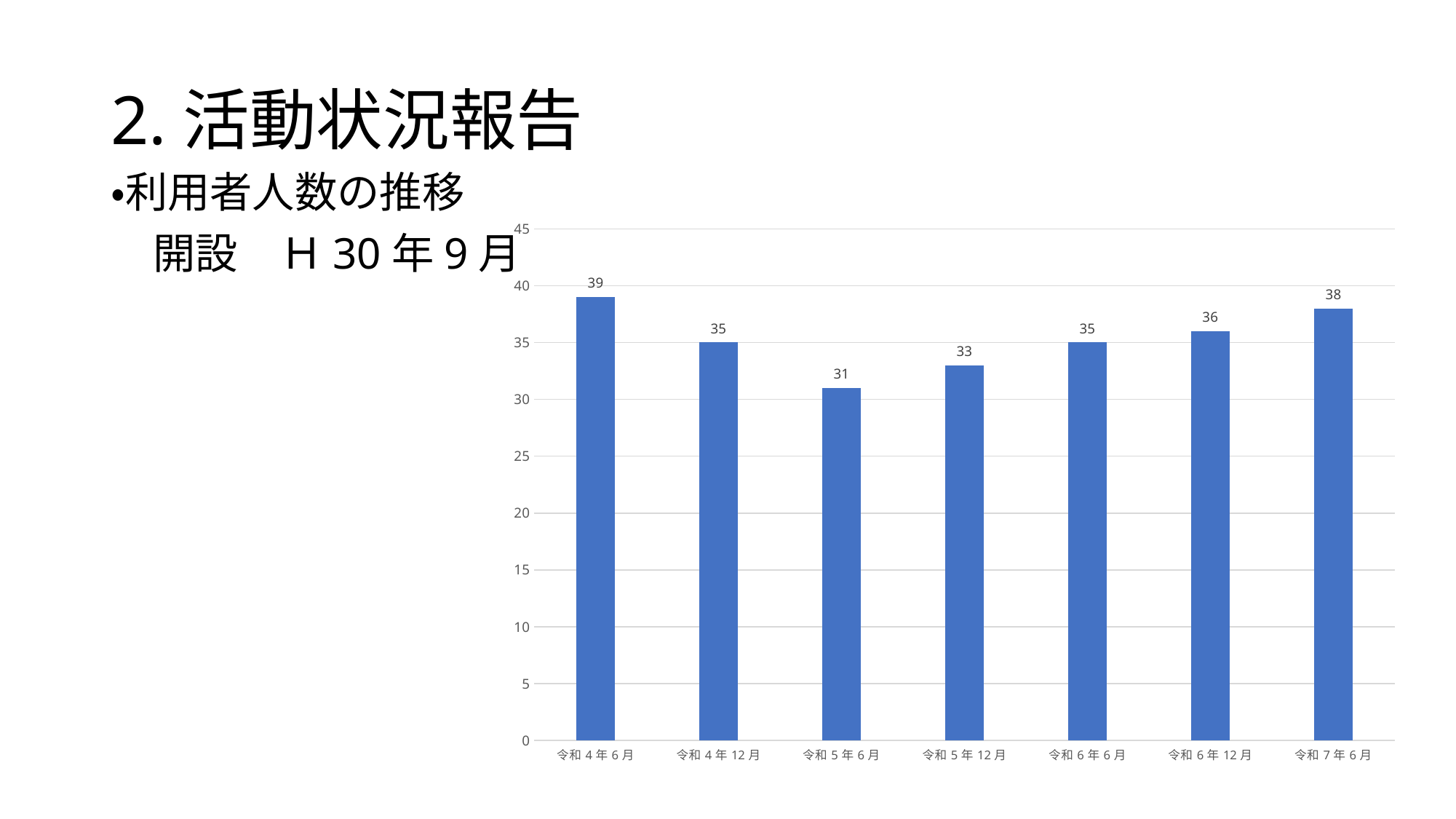
What is the difference between the values for 令和4年6月 and 令和5年6月? 8 What is the value for 令和4年6月? 39 Which category has the lowest value? 令和5年6月 What kind of chart is shown on the slide? bar chart What is the value for 令和5年12月? 33 What is the value for 令和7年6月? 38 What is the maximum value shown on the vertical axis? 45 Which is larger, the value for 令和6年12月 or the value for 令和5年12月? 令和6年12月 Is the value for 令和5年6月 greater or less than 35? less Do the values rise or fall from 令和5年6月 to 令和7年6月? rise Which category has the highest value? 令和4年6月 How many categories are shown on the x axis? 7